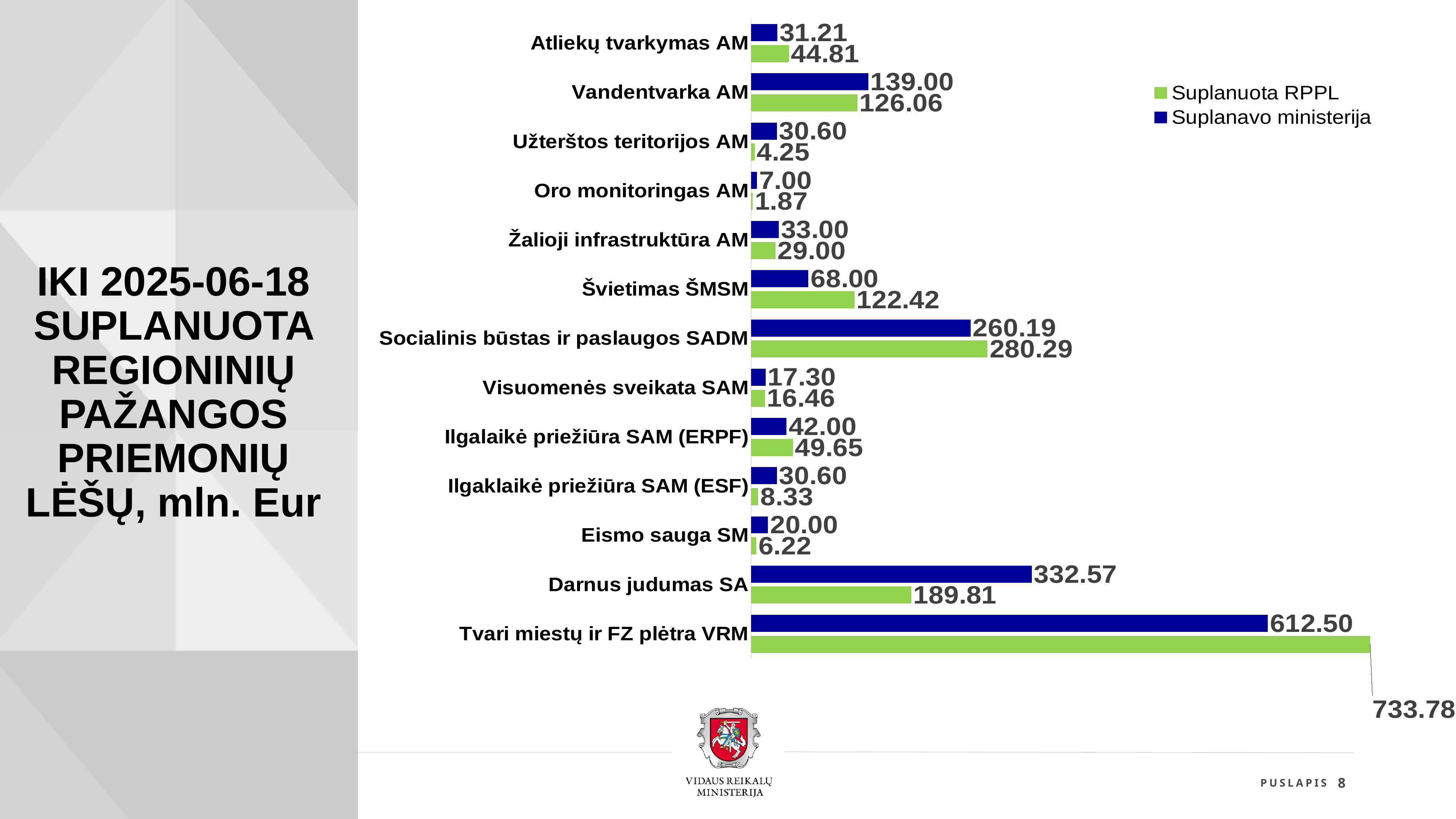
What kind of chart is shown on the slide? Bar chart For Socialinis būstas ir paslaugos SADM, which is larger: Suplanuota RPPL or Suplanavo ministerija? Suplanuota RPPL Which category has the highest Suplanavo ministerija value? Tvari miestų ir FZ plėtra VRM What is the Suplanavo ministerija value for Darnus judumas SA? 332.57 Which category has the lowest Suplanuota RPPL value? Oro monitoringas AM How many categories are shown in the chart? 13 Which colour represents the Suplanuota RPPL series? Green What is the Suplanuota RPPL value for Tvari miestų ir FZ plėtra VRM? 733.78 What is the difference between the Suplanavo ministerija and Suplanuota RPPL values for Darnus judumas SA? 142.76 How many series does the legend list? 2 What is the Suplanuota RPPL value for Švietimas ŠMSM? 122.42 For Vandentvarka AM, which is larger: Suplanuota RPPL or Suplanavo ministerija? Suplanavo ministerija